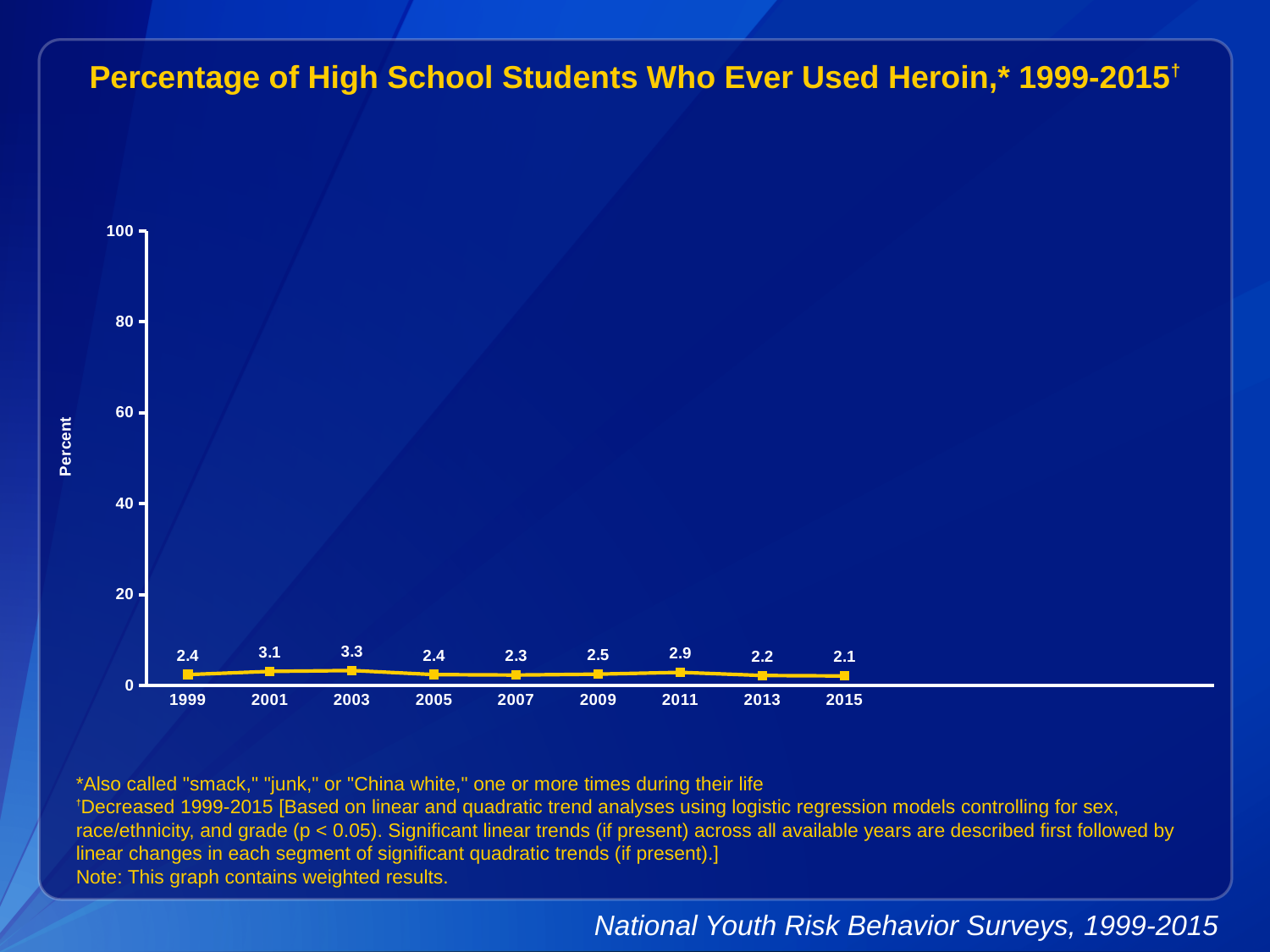
Which year has a larger value, 2001 or 2013? 2001 Which year has the lowest percentage of students who ever used heroin? 2015 How many years are plotted on the chart? 9 What is the value plotted for 1999? 2.4 What is the label on the y axis? Percent What percentage of high school students had ever used heroin in 2003? 3.3 Which year has the highest percentage of students who ever used heroin? 2003 Is the value for 2011 greater or less than 20? less What is the maximum value shown on the y axis? 100 What is the value plotted for 2015? 2.1 What kind of chart is shown on the slide? line chart What is the difference between the values for 2003 and 2015? 1.2